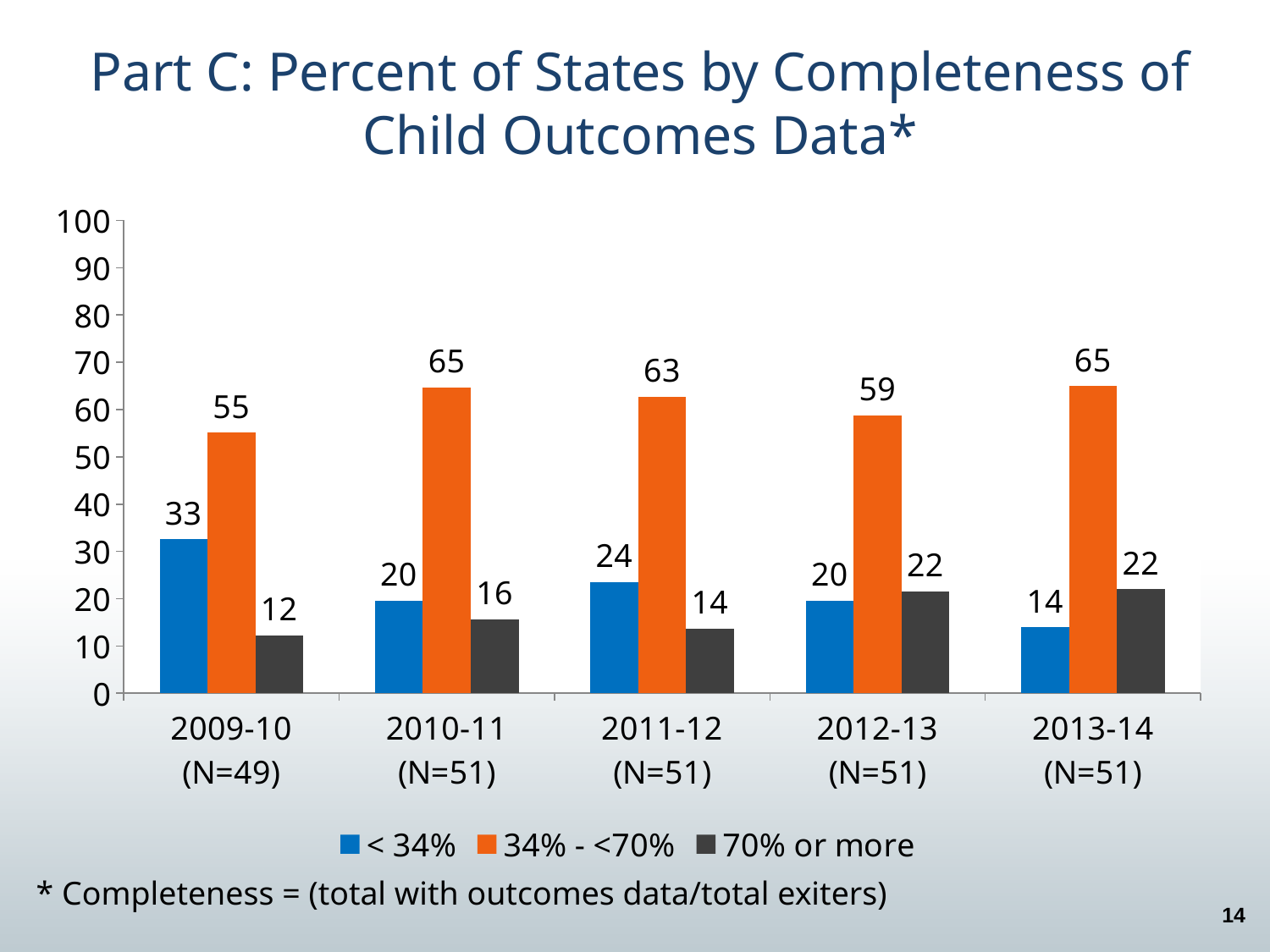
What is the value for the "70% or more" series in 2013-14? 22 How many year categories are shown on the x axis? 5 Does the "< 34%" series generally rise or fall from 2009-10 to 2013-14? Fall In which year is the "70% or more" series lowest? 2009-10 In which year is the "< 34%" series highest? 2009-10 What kind of chart is shown on the slide? Bar chart How many series does the legend list? 3 What is the value for the "< 34%" series in 2009-10? 33 What is the difference between the "34% - <70%" value and the "< 34%" value in 2012-13? 39 What is the title of the chart? Part C: Percent of States by Completeness of Child Outcomes Data* Which is larger in 2010-11: the "< 34%" value or the "70% or more" value? < 34% What is the value for the "34% - <70%" series in 2011-12? 63